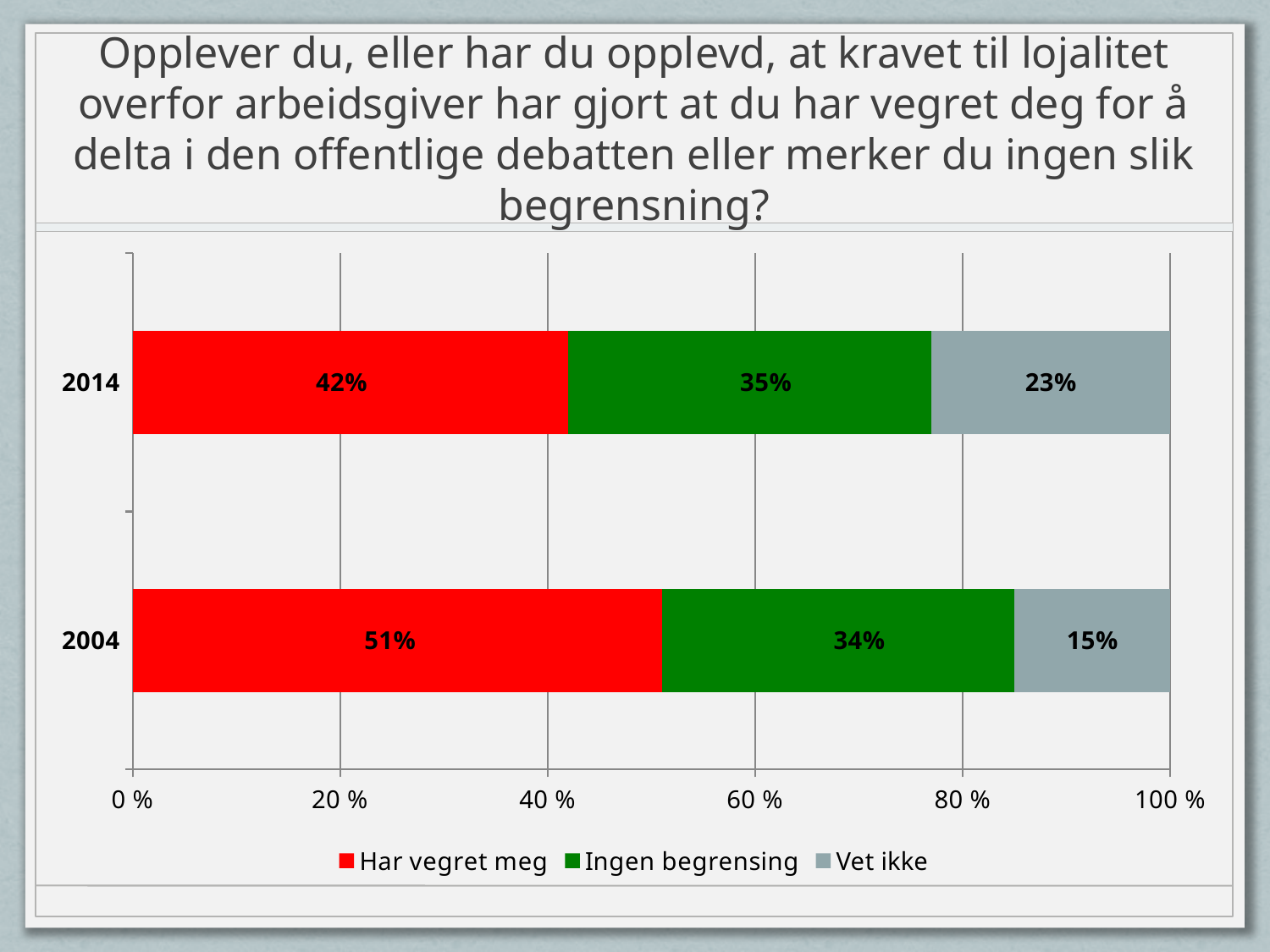
What kind of chart is shown on the slide? Stacked bar chart What is the value for "Har vegret meg" in 2014? 42% What colour represents "Ingen begrensing" in the chart? Green Which year has the higher value for "Har vegret meg"? 2004 How many series does the legend list? 3 What is the value for "Vet ikke" in 2004? 15% How many years (categories) are shown on the chart? 2 Which series has the lowest value in the 2004 bar? Vet ikke Which series has the highest value in the 2014 bar? Har vegret meg What is the difference between the "Har vegret meg" values for 2004 and 2014? 9% What is the difference between the "Vet ikke" values for 2014 and 2004? 8% What is the value for "Ingen begrensing" in 2014? 35%